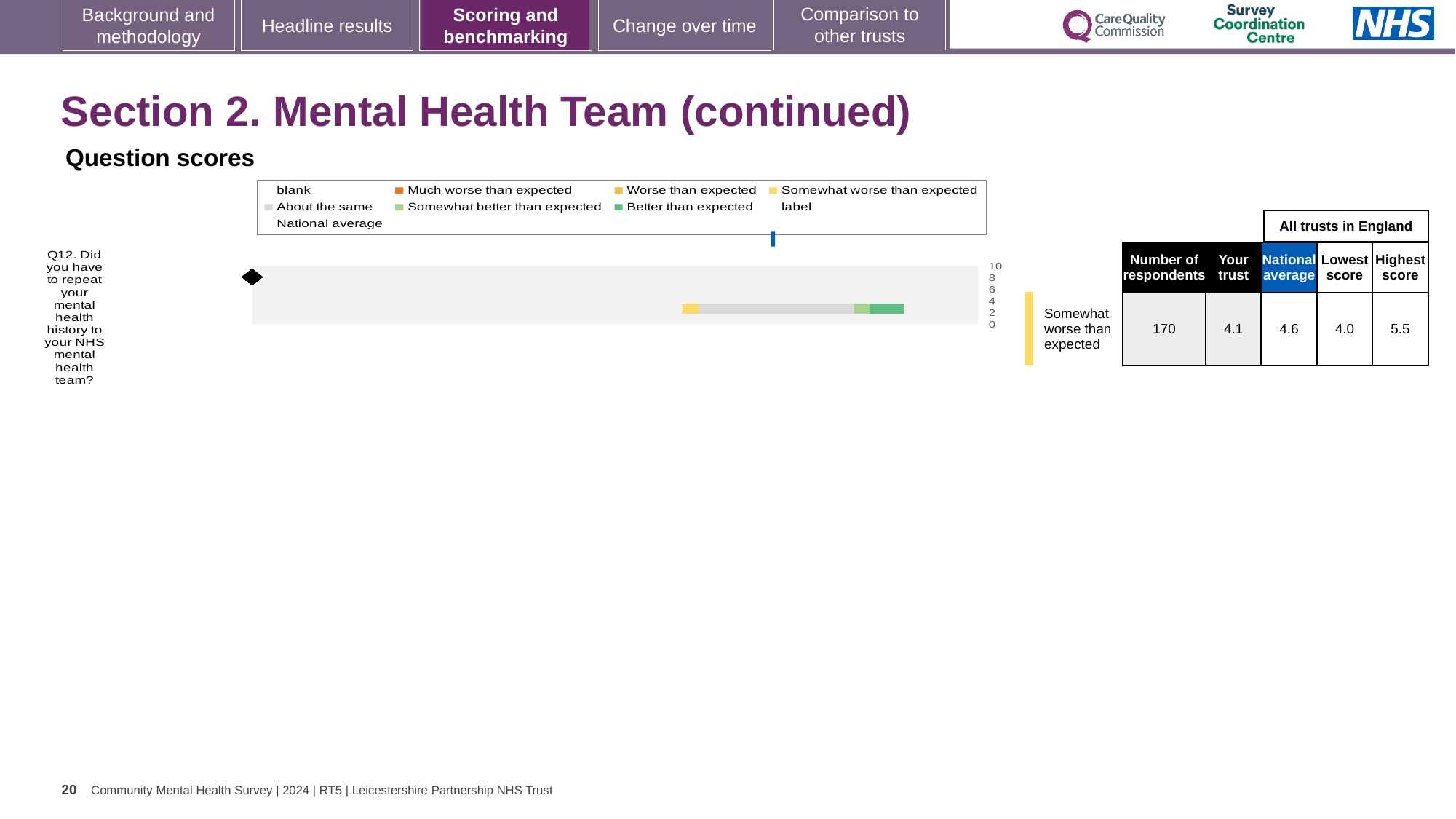
Which benchmark category is Q12 assigned to on this slide? Somewhat worse than expected What is the Lowest score among all trusts in England for Q12? 4.0 What is the National average score for Q12? 4.6 What is the difference between the Highest score and the Lowest score for Q12? 1.5 What is the 'Your trust' score for Q12 in the table next to the chart? 4.1 What is the Highest score among all trusts in England for Q12? 5.5 Which is larger for Q12: the 'Your trust' score or the National average? National average By how much does the National average exceed the 'Your trust' score for Q12? 0.5 How many respondents answered Q12? 170 What colour does the legend use for 'Better than expected'? green How many survey questions are plotted in the Question scores chart? 1 What kind of chart is shown under 'Question scores'? bar chart